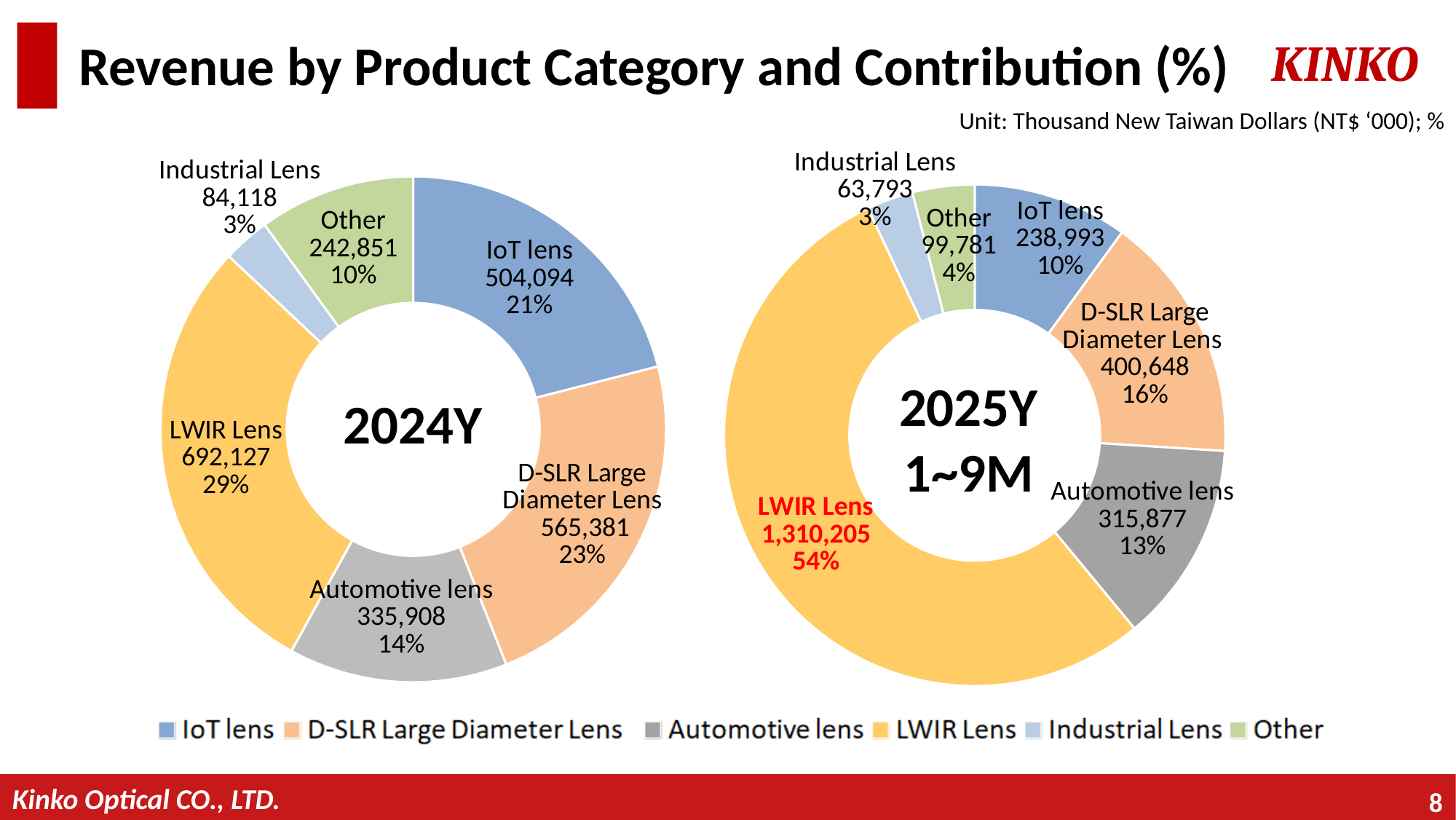
In the 2024Y chart, what is the difference in revenue between D-SLR Large Diameter Lens and IoT lens? 61,287 In the 2024Y chart, what percentage share does Automotive lens have? 14% In the 2025Y 1~9M chart, which product category has the highest revenue? LWIR Lens In the 2025Y 1~9M chart, which is larger: the revenue for D-SLR Large Diameter Lens or Automotive lens? D-SLR Large Diameter Lens In the 2024Y chart, which product category has the lowest revenue? Industrial Lens How many product categories are shown in the 2024Y chart? 6 What type of chart is used to show the 2024Y revenue breakdown? Donut (pie) chart In the 2025Y 1~9M chart, what is the revenue for Other? 99,781 In the 2025Y 1~9M chart, what is the difference in revenue between D-SLR Large Diameter Lens and Automotive lens? 84,771 In the 2024Y chart, what is the revenue for LWIR Lens? 692,127 In the 2025Y 1~9M chart, what percentage share does LWIR Lens have? 54% How many entries does the legend list? 6